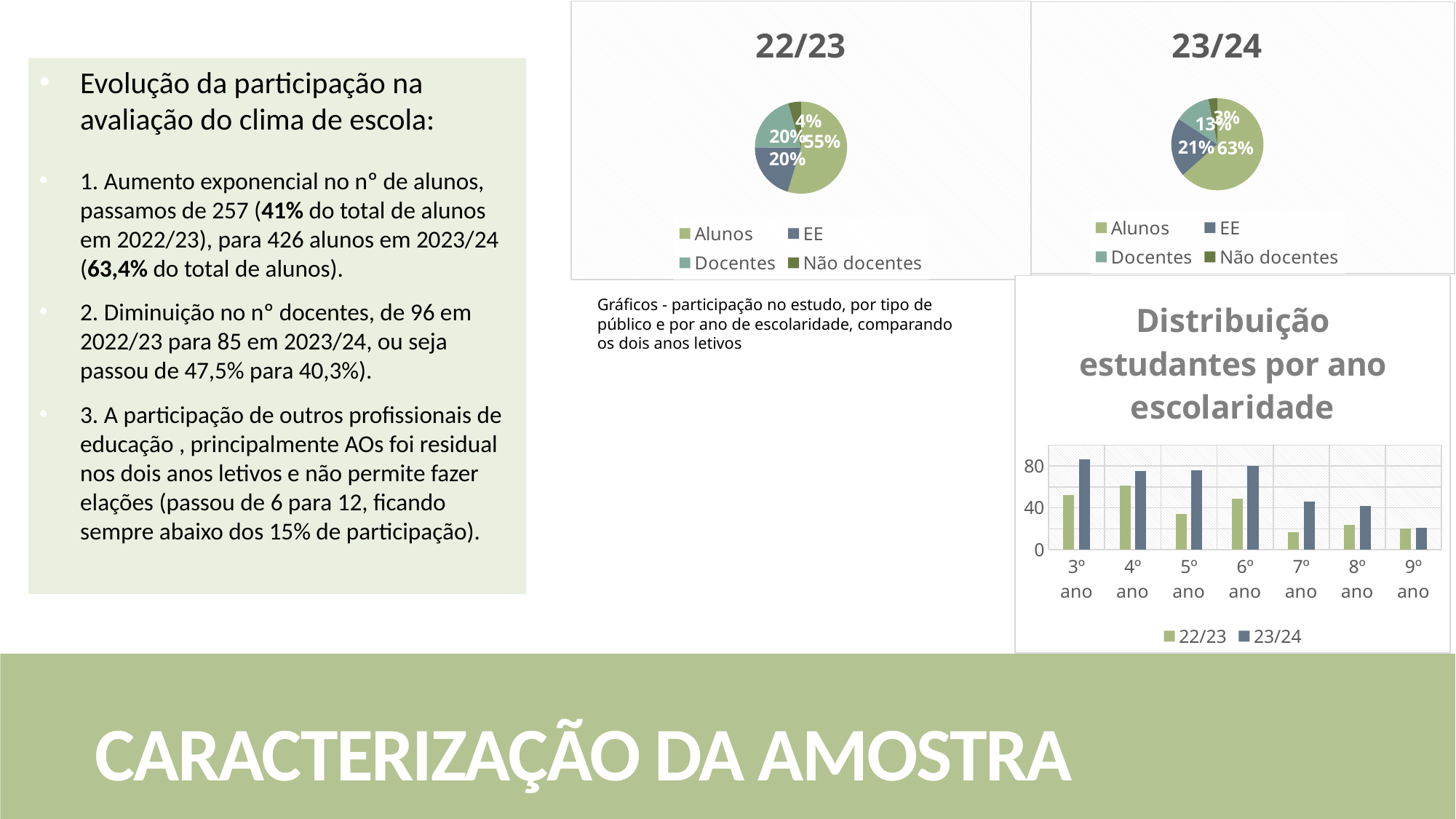
How many categories does the legend of the 23/24 pie chart list? 4 In the 22/23 pie chart, which category has the smallest slice? Não docentes In the 'Distribuição estudantes por ano escolaridade' chart, which series has the larger value for 5º ano, 22/23 or 23/24? 23/24 In the 22/23 pie chart, what percentage is shown for Alunos? 55% In the 22/23 pie chart, what is the difference between the Alunos and EE percentages? 35% In the 'Distribuição estudantes por ano escolaridade' chart, is the 22/23 value for 7º ano greater or less than 40? less In the 'Distribuição estudantes por ano escolaridade' chart, is the 23/24 value for 3º ano greater or less than 80? greater In the 23/24 pie chart, what percentage is shown for Docentes? 13% How many series does the legend of the 'Distribuição estudantes por ano escolaridade' chart list? 2 In the 23/24 pie chart, which category has the largest slice? Alunos What kind of chart is 'Distribuição estudantes por ano escolaridade'? Bar chart In the 23/24 pie chart, what percentage is shown for EE? 21%